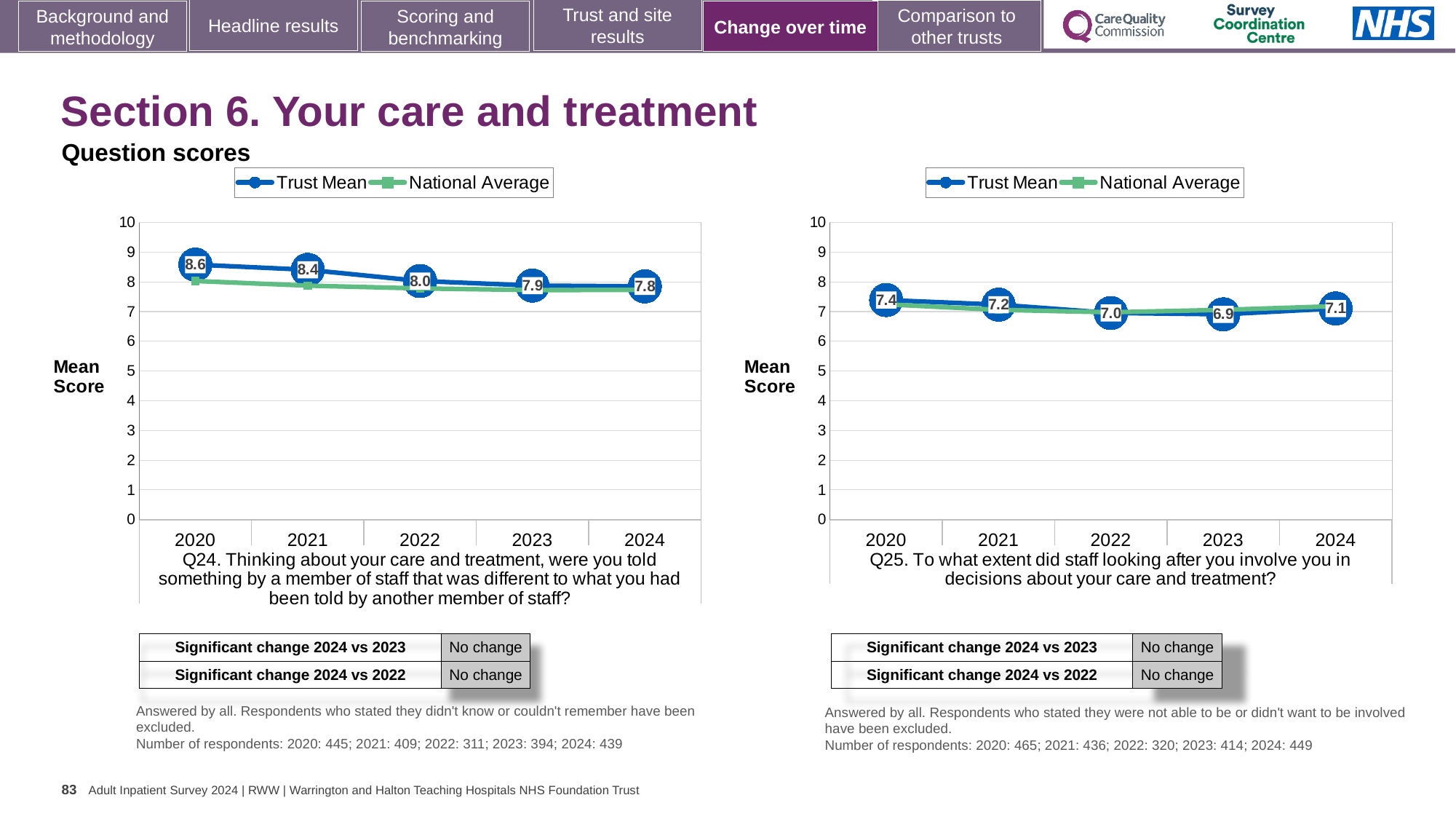
In the Q25 chart (right), which is larger, the Trust Mean score for 2020 or for 2022? 2020 How many years are shown on the x axis of the Q25 chart (right)? 5 In the Q24 chart (left), what is the Trust Mean score for 2024? 7.8 In the Q25 chart (right), what is the Trust Mean score for 2023? 6.9 In the Q24 chart (left), what is the difference between the Trust Mean scores for 2020 and 2024? 0.8 In the Q24 chart (left), which year has the highest Trust Mean score? 2020 In the Q24 chart (left), is the National Average value for 2020 greater or less than 9? less In the Q24 chart (left), what is the Trust Mean score for 2020? 8.6 In the Q25 chart (right), what is the Trust Mean score for 2024? 7.1 In the Q24 chart (left), does the Trust Mean score rise or fall from 2020 to 2024? fall In the Q25 chart (right), which year has the lowest Trust Mean score? 2023 How many series does the legend of the Q24 chart (left) list? 2